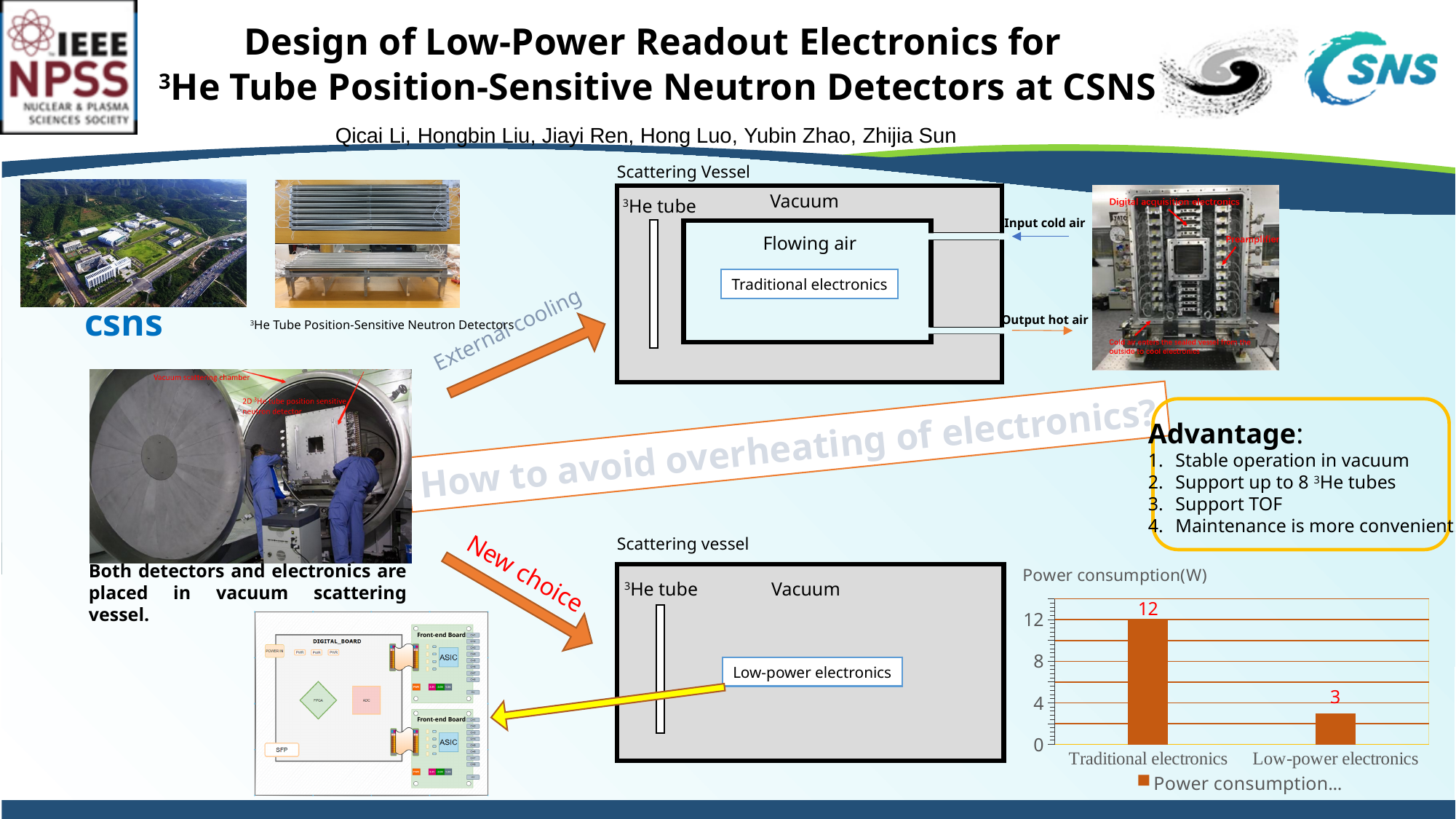
Is the power consumption for Traditional electronics greater or less than 8? greater Is the power consumption for Low-power electronics greater or less than 4? less What is the power consumption value shown for Low-power electronics? 3 Which has a larger power consumption, Traditional electronics or Low-power electronics? Traditional electronics What is the title of the chart on the slide? Power consumption(W) Which category has the lowest power consumption in the chart? Low-power electronics How many categories are shown in the power consumption chart? 2 What kind of chart is the power consumption chart? bar chart What is the highest value labelled on the vertical axis of the power consumption chart? 12 What is the difference in power consumption between Traditional electronics and Low-power electronics? 9 Which category has the highest power consumption in the chart? Traditional electronics What is the power consumption value shown for Traditional electronics? 12